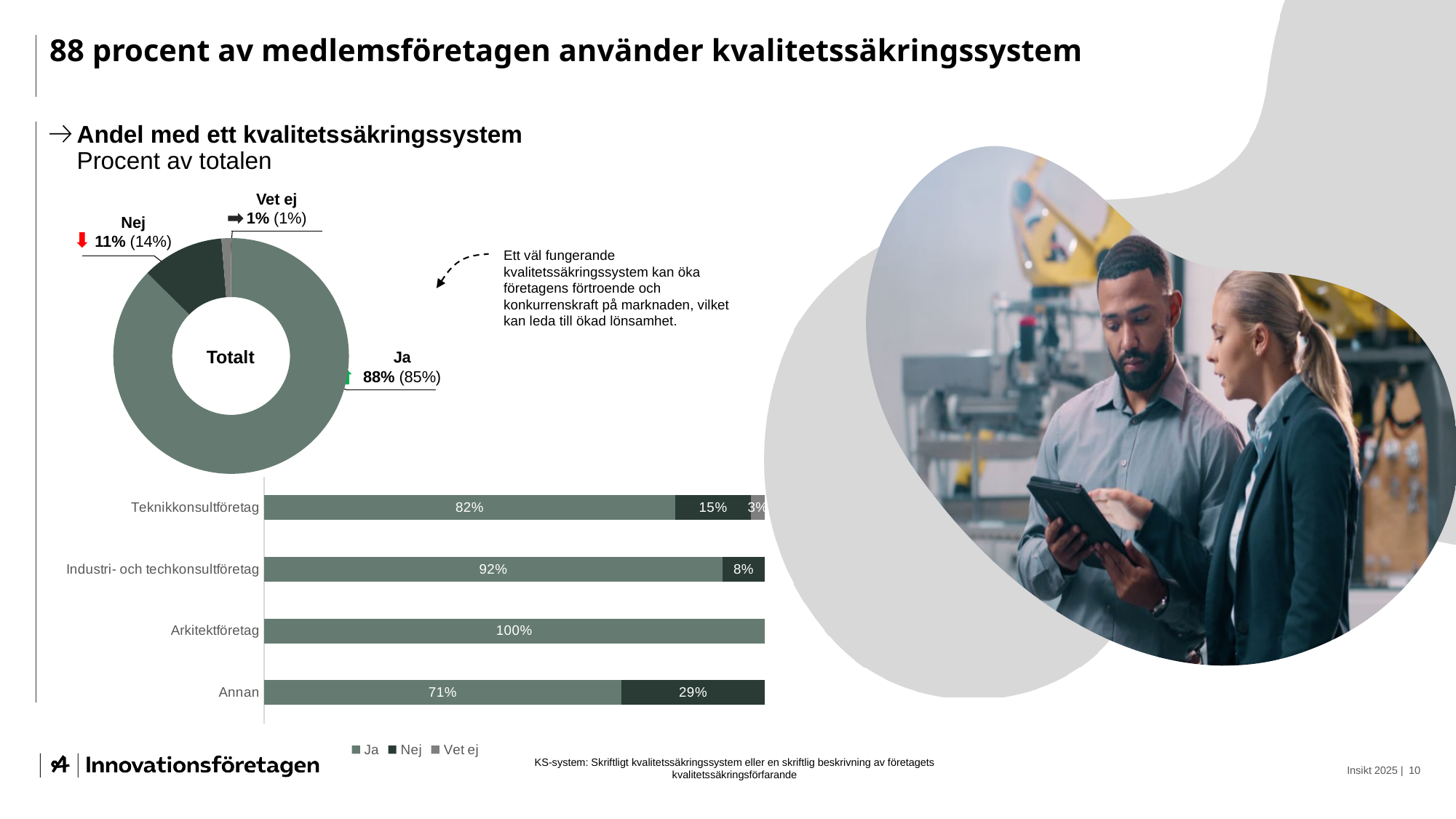
In the stacked bar chart, which category has the highest Ja value? Arkitektföretag In the stacked bar chart, what is the Nej value for Annan? 29% In the stacked bar chart, which category has the lowest Ja value? Annan In the donut chart labelled Totalt, what share answered Ja? 88% In the donut chart labelled Totalt, what is the value shown in parentheses next to Ja 88%? 85% In the donut chart labelled Totalt, which answer has the largest share? Ja How many categories are shown in the stacked bar chart? 4 In the stacked bar chart, what is the Ja value for Teknikkonsultföretag? 82% In the donut chart labelled Totalt, what share answered Vet ej? 1% In the stacked bar chart, what is the difference between the Ja values for Industri- och techkonsultföretag and Teknikkonsultföretag? 10% How many series does the legend of the stacked bar chart list? 3 In the donut chart labelled Totalt, what share answered Nej? 11%